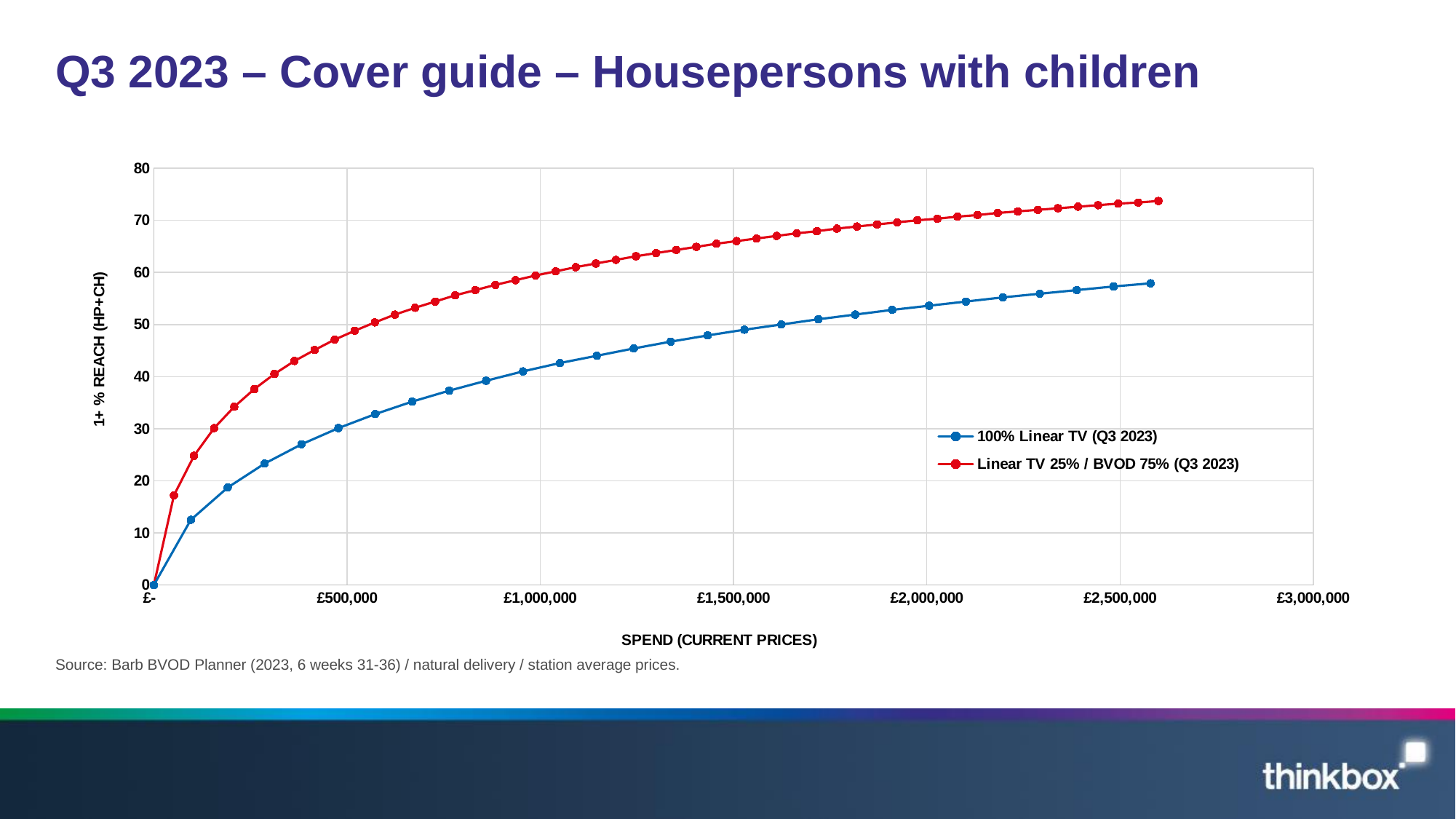
Which series reaches the higher value at the right-hand end of the chart? Linear TV 25% / BVOD 75% (Q3 2023) What kind of chart is shown on the slide? line chart Do the values for 100% Linear TV (Q3 2023) rise or fall as spend increases? rise Is the value for 100% Linear TV (Q3 2023) at £2,500,000 greater or less than 60? less Is the value for 100% Linear TV (Q3 2023) at £2,000,000 greater or less than 50? greater What is the title of the y axis? 1+ % REACH (HP+CH) Is the value for Linear TV 25% / BVOD 75% (Q3 2023) at £500,000 greater or less than 40? greater At a spend of £1,000,000, which series has the higher reach: 100% Linear TV (Q3 2023) or Linear TV 25% / BVOD 75% (Q3 2023)? Linear TV 25% / BVOD 75% (Q3 2023) How many series does the legend list? 2 Which series is shown in red? Linear TV 25% / BVOD 75% (Q3 2023)